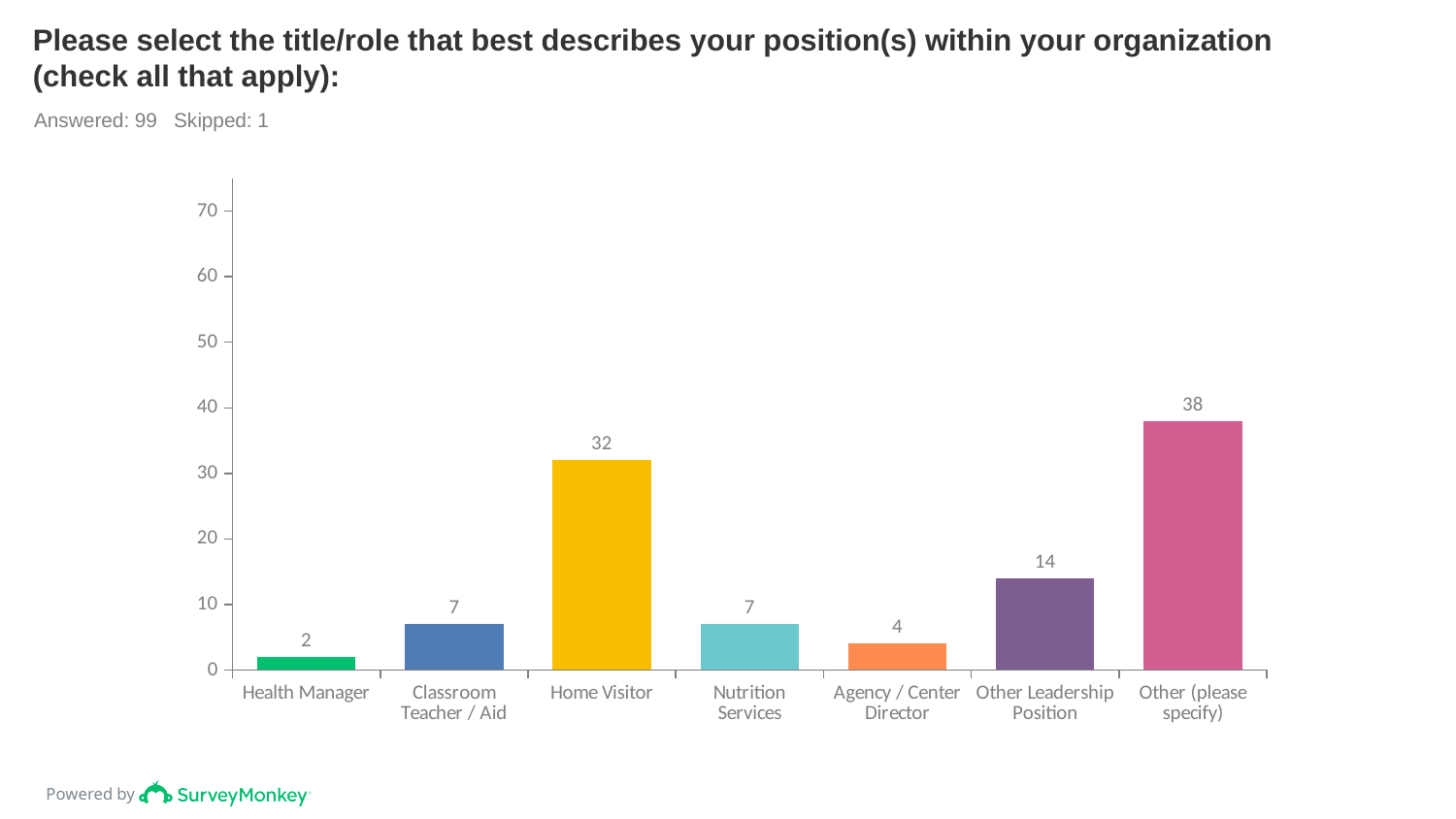
What is the value for Agency / Center Director? 4 Is the value for Home Visitor greater or less than 40? less What is the value for Home Visitor? 32 What is the difference between the values for Other (please specify) and Home Visitor? 6 Which category has the highest value? Other (please specify) What kind of chart is shown on the slide? bar chart How many respondents answered the question according to the slide? 99 Which is larger, the value for Other Leadership Position or the value for Nutrition Services? Other Leadership Position What colour is the bar for Home Visitor? yellow How many categories are shown on the x axis? 7 Which category has the lowest value? Health Manager What is the value for Other Leadership Position? 14